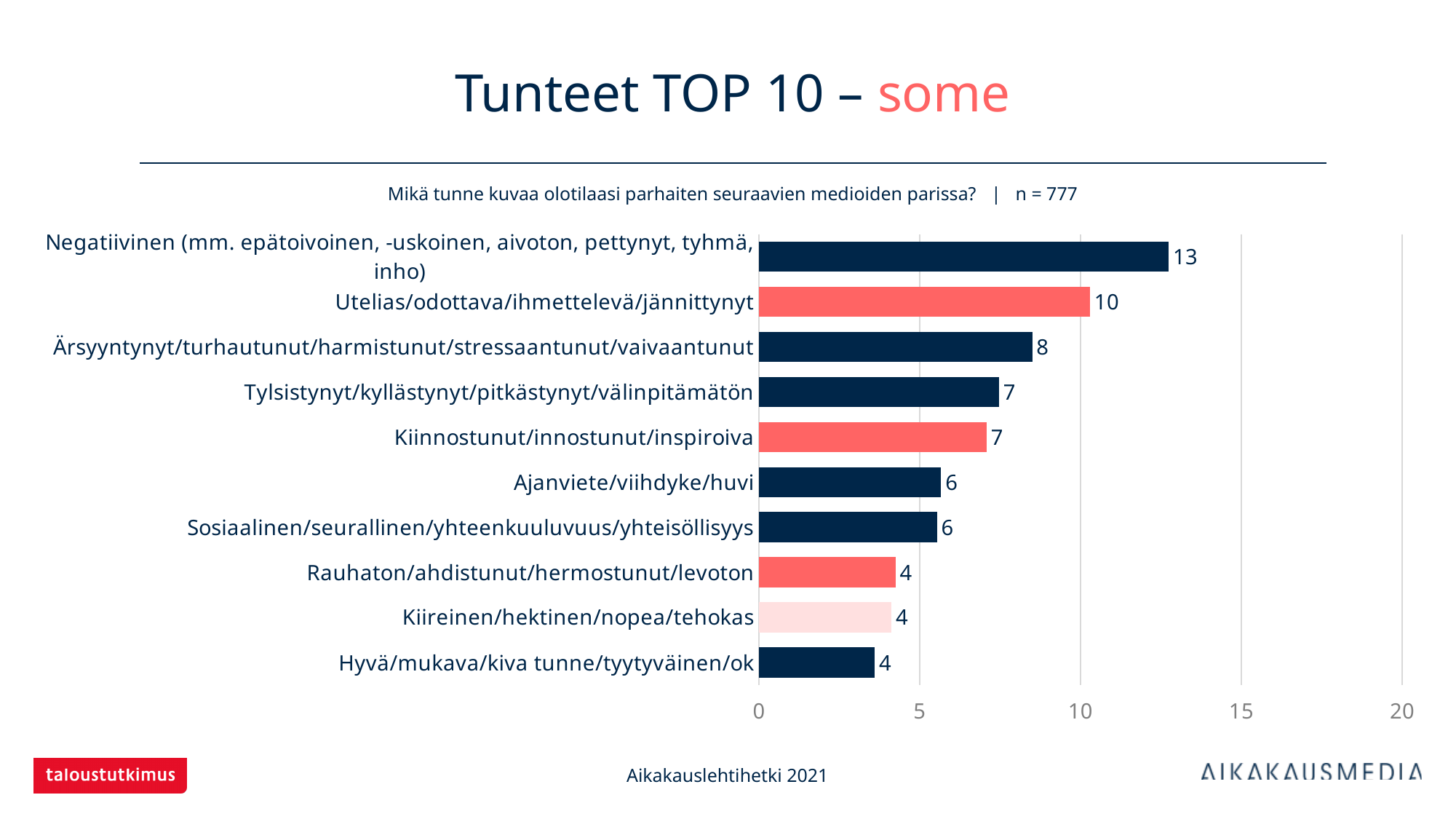
Is the value for Negatiivinen greater or less than 10? greater What kind of chart is shown on the slide? bar chart What is the value for Ajanviete/viihdyke/huvi? 6 Which is larger, the value for Tylsistynyt/kyllästynyt/pitkästynyt/välinpitämätön or the value for Hyvä/mukava/kiva tunne/tyytyväinen/ok? Tylsistynyt/kyllästynyt/pitkästynyt/välinpitämätön What is the difference between the values for Ärsyyntynyt/turhautunut/harmistunut/stressaantunut/vaivaantunut and Rauhaton/ahdistunut/hermostunut/levoton? 4 What is the difference between the values for Negatiivinen and Utelias/odottava/ihmettelevä/jännittynyt? 3 Which category has the highest value? Negatiivinen (mm. epätoivoinen, -uskoinen, aivoton, pettynyt, tyhmä, inho) How many categories are shown in the chart? 10 What is the value for Utelias/odottava/ihmettelevä/jännittynyt? 10 What is the sample size (n) stated on the slide? n = 777 What is the value for Kiireinen/hektinen/nopea/tehokas? 4 What is the value for Ärsyyntynyt/turhautunut/harmistunut/stressaantunut/vaivaantunut? 8